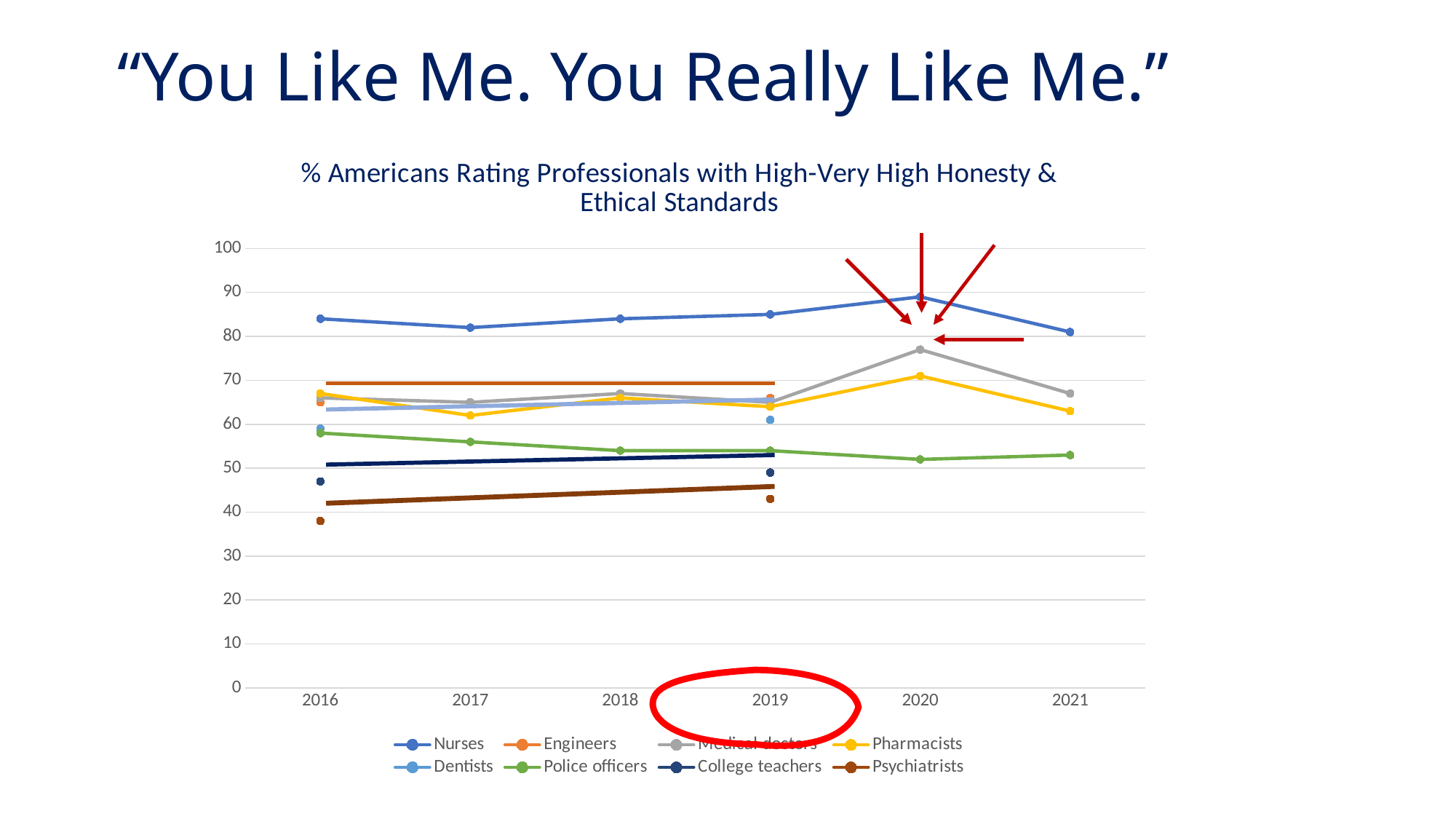
Is the value for College teachers in 2016 greater or less than 50? less Is the value for Psychiatrists in 2016 greater or less than 40? less Which profession has the highest rating in 2020? Nurses How many years are shown along the x axis of the chart? 6 Does the Police officers line rise or fall from 2016 to 2020? Fall What kind of chart is shown on the slide? Line chart In 2021, which is higher: Pharmacists or Police officers? Pharmacists Which profession has the lowest rating in 2016? Psychiatrists How many series does the chart legend list? 8 What is the title of the chart? % Americans Rating Professionals with High-Very High Honesty & Ethical Standards Is the value for Nurses in 2020 greater or less than 80? greater